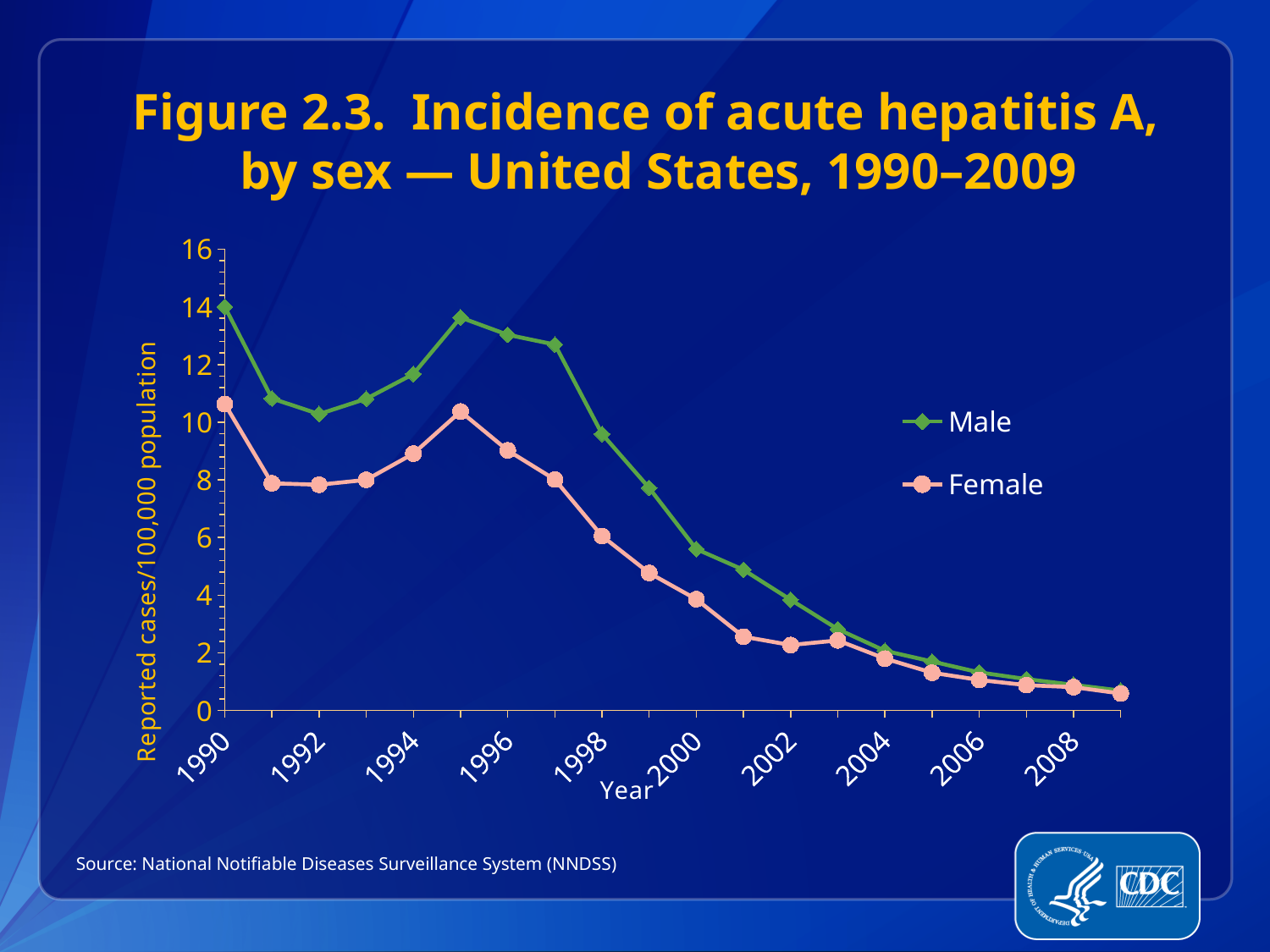
Do the values for both series rise or fall from 1997 to 2009? fall In 1996, which series has the higher value, Male or Female? Male How many years (data points) are plotted for each series? 20 Is the Female value for 1992 greater or less than 10? less Is the Female value for 2000 greater or less than 6? less How many series does the legend list? 2 What kind of chart is shown on the slide? line chart In which year is the Male series at its lowest value? 2009 Is the Male value for 1998 greater or less than 8? greater What is the label on the y axis? Reported cases/100,000 population